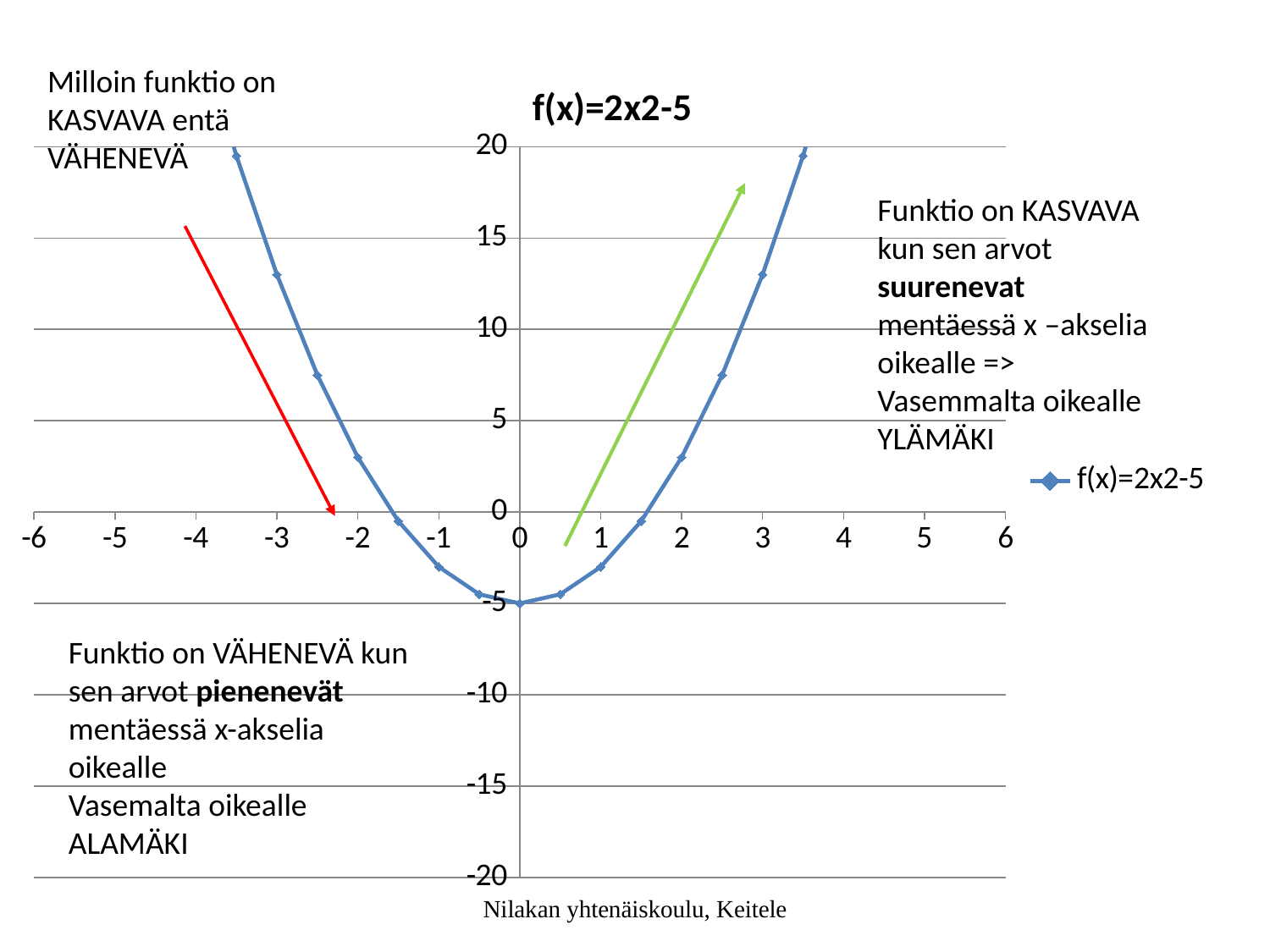
What is the value of f(x) at x = 0? -5 Is the value of f(x) at x = 3 greater or less than 10? greater What is the title of the chart? f(x)=2x2-5 Do the values of f(x) rise or fall as x goes from -3.5 to 0? fall Which is larger, the value of f(x) at x = -3 or at x = -1? x = -3 Is the value of f(x) at x = 2 greater or less than 0? greater At which x value does the plotted function reach its lowest point? 0 Which is larger, the value of f(x) at x = 3 or at x = 2? x = 3 Is the value of f(x) at x = -1 greater or less than 0? less What kind of chart is shown on the slide? line chart Do the values of f(x) rise or fall as x goes from 0 to 3.5? rise How many series does the legend list? 1